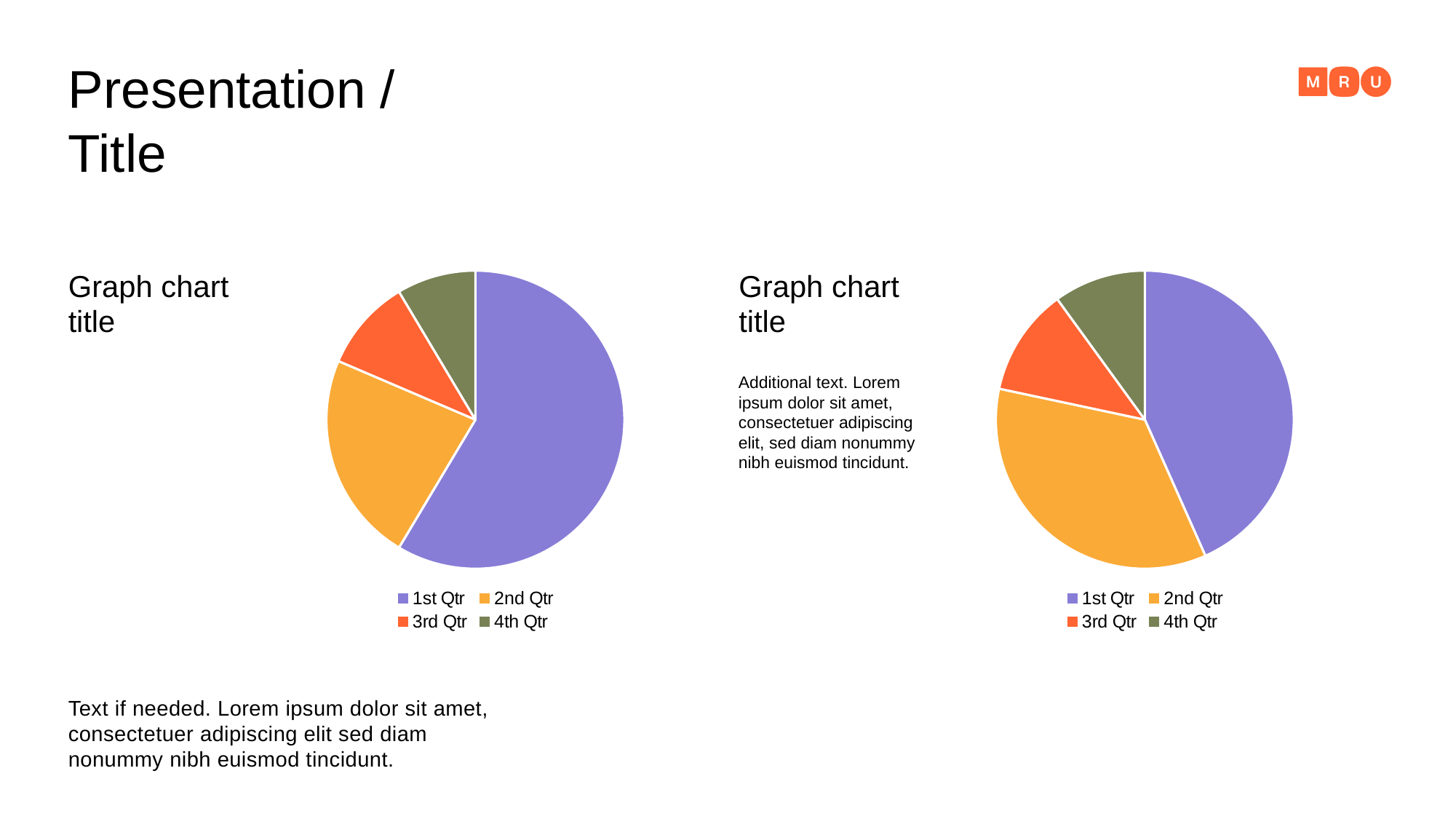
What kind of chart is the left chart on the slide? Pie chart In the left pie chart, which slice is larger, 1st Qtr or 4th Qtr? 1st Qtr What kind of chart is the right chart on the slide? Pie chart In the left pie chart, which category has the largest slice? 1st Qtr In the left pie chart, which slice is larger, 2nd Qtr or 3rd Qtr? 2nd Qtr In the left pie chart, what colour is the 2nd Qtr slice? Orange/yellow In the left pie chart, how many slices does the pie have? 4 In the right pie chart, which category has the largest slice? 1st Qtr What is the title shown for the right chart? Graph chart title In the right pie chart, how many categories does the legend list? 4 In the right pie chart, which slice is larger, 1st Qtr or 2nd Qtr? 1st Qtr